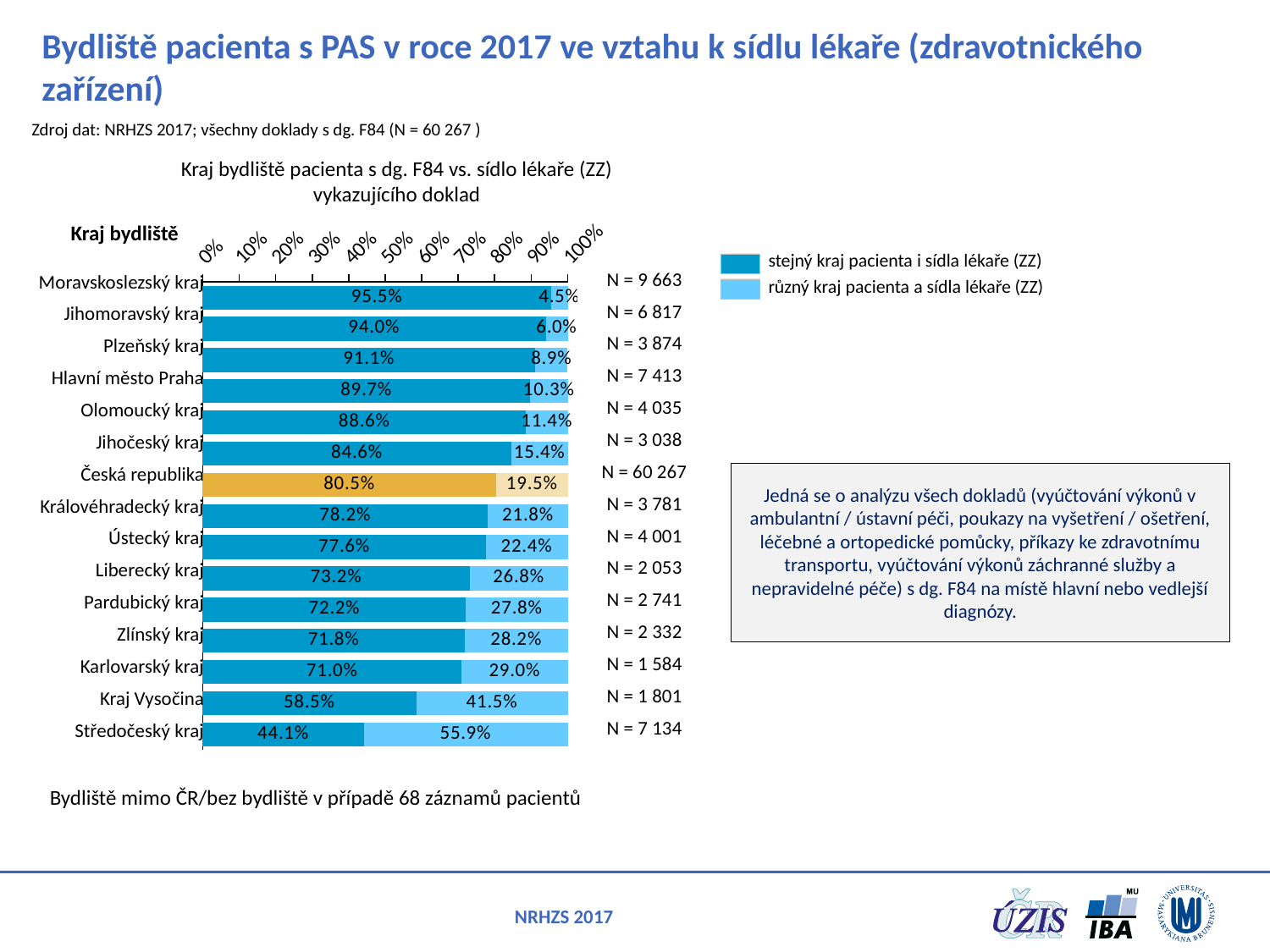
Which has a larger 'různý kraj' share: Kraj Vysočina or Karlovarský kraj? Kraj Vysočina How many categories (rows) are shown on the bar chart? 15 How many series does the legend list? 2 What kind of chart is shown on the slide? Stacked bar chart What is the total of the stacked bar for Liberecký kraj? 100% Which region has the highest share of 'stejný kraj pacienta i sídla lékaře (ZZ)'? Moravskoslezský kraj Which region has the lowest share of 'stejný kraj pacienta i sídla lékaře (ZZ)'? Středočeský kraj What is the N value shown for Hlavní město Praha? N = 7 413 What is the 'stejný kraj' share for Česká republika? 80.5% What is the value for 'různý kraj pacienta a sídla lékaře (ZZ)' for Středočeský kraj? 55.9% What is the difference between the 'stejný kraj' share for Jihomoravský kraj and Plzeňský kraj? 2.9% What percentage of documents for Moravskoslezský kraj have the same region for patient and physician (stejný kraj)? 95.5%